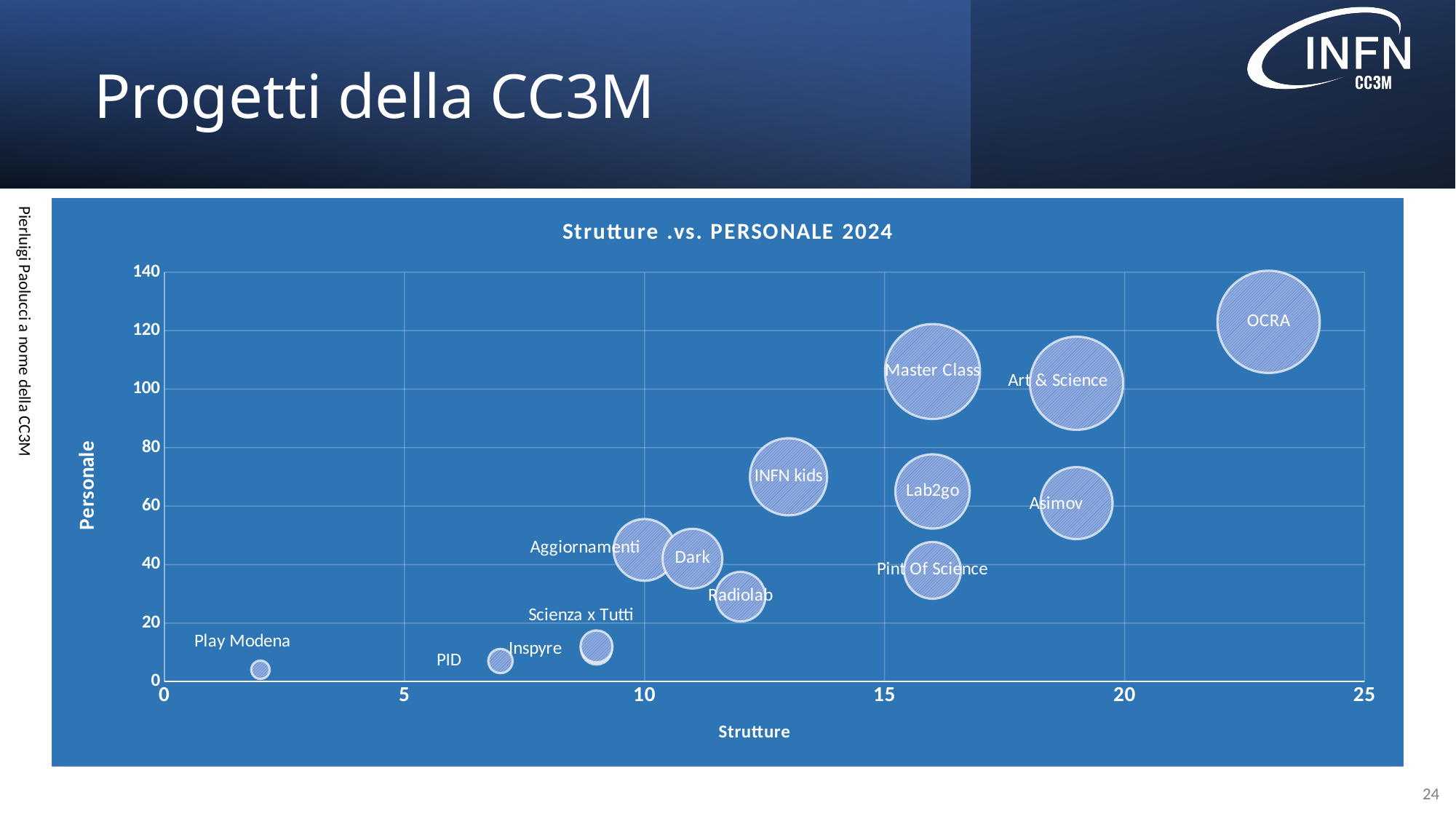
Which project has the highest Strutture value? OCRA What kind of chart is shown on the slide? bubble chart Is the Personale value for INFN kids greater or less than 60? greater Is the Personale value for Master Class greater or less than 100? greater Is the Strutture value for Asimov greater or less than 15? greater What is the label of the vertical axis of the chart? Personale Which project has the lowest Personale value? Play Modena Which project has the lowest Strutture value? Play Modena Which project has the highest Personale value? OCRA Which project has a higher Personale value, INFN kids or Dark? INFN kids What is the title of the chart? Strutture .vs. PERSONALE 2024